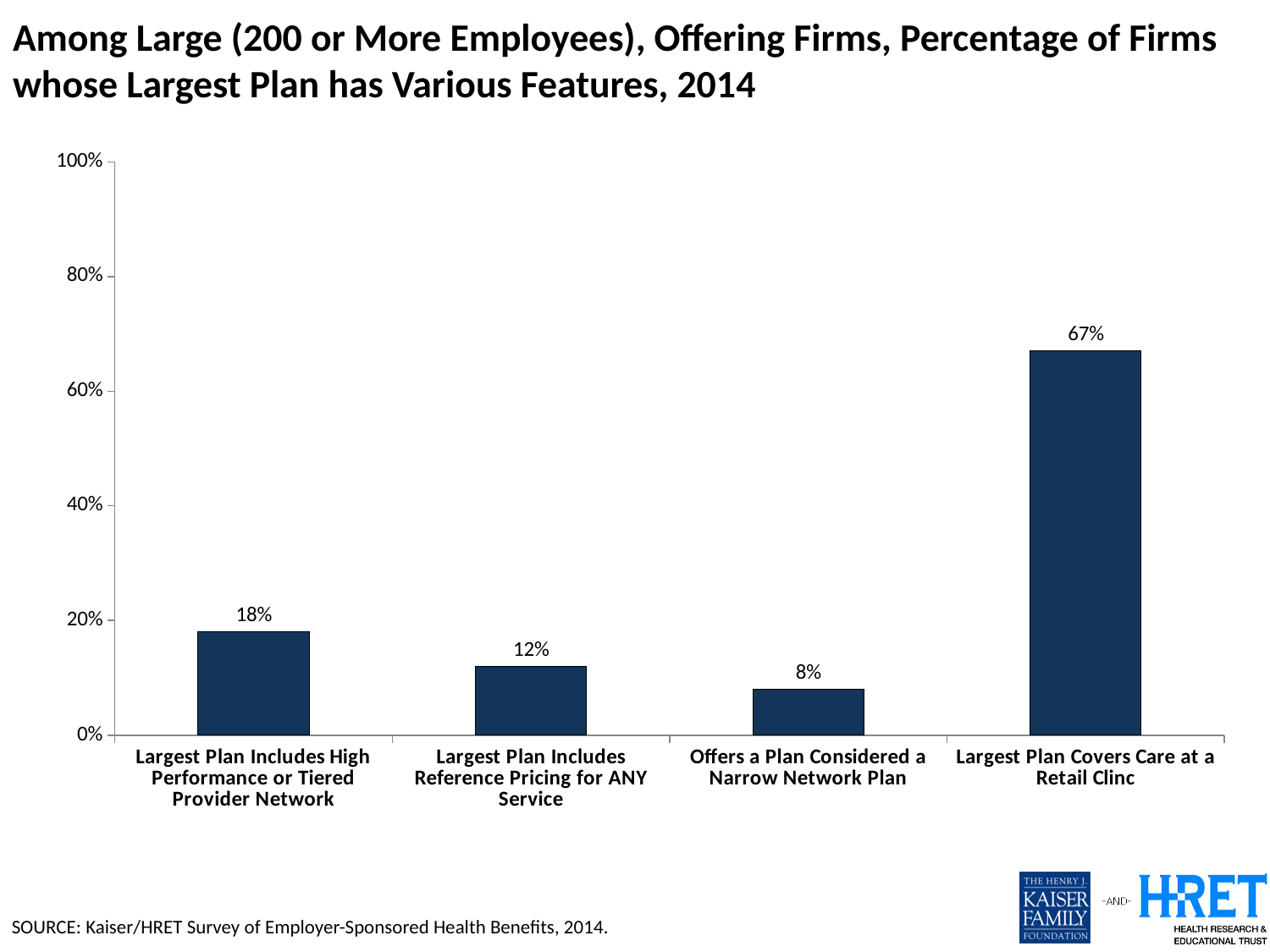
What is the difference in percentage points between firms whose largest plan includes reference pricing for any service and firms that offer a narrow network plan? 4 percentage points What percentage of large offering firms have a largest plan that includes a high performance or tiered provider network? 18% What is the difference in percentage points between firms whose largest plan covers care at a retail clinic and firms whose largest plan includes a high performance or tiered provider network? 49 percentage points Which is larger: the percentage of firms whose largest plan includes a high performance or tiered provider network, or the percentage whose largest plan includes reference pricing for any service? Largest Plan Includes High Performance or Tiered Provider Network What percentage of large offering firms offer a plan considered a narrow network plan? 8% Which plan feature has the highest percentage of firms? Largest Plan Covers Care at a Retail Clinic How many plan features are shown on the chart? 4 Is the value for firms whose largest plan covers care at a retail clinic greater or less than 60%? greater What type of chart is shown on the slide? Bar chart What percentage of large offering firms have a largest plan that includes reference pricing for any service? 12% Which plan feature has the lowest percentage of firms? Offers a Plan Considered a Narrow Network Plan What percentage of large offering firms have a largest plan that covers care at a retail clinic? 67%